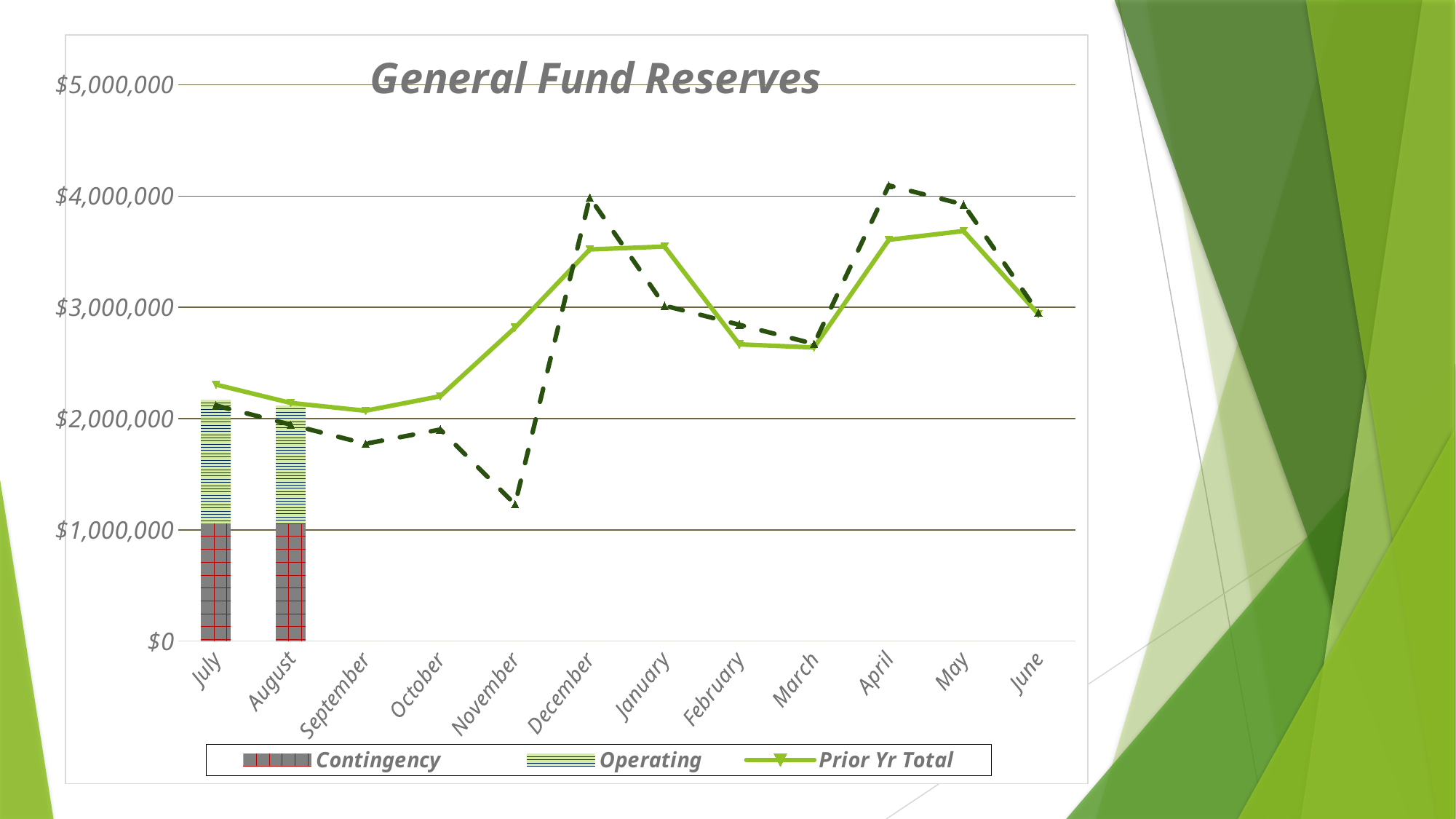
In which month does the dashed line reach its lowest value? November How many series does the legend list? 3 Does the Prior Yr Total line rise or fall from September to December? rise What is the title of the chart? General Fund Reserves Is the total height of the stacked bar for July greater or less than $2,000,000? greater How many months are shown on the x axis? 12 For how many months are stacked bars plotted? 2 Is the Prior Yr Total value for July greater or less than $3,000,000? less What kind of chart is this? A combination bar and line chart In which month does the Prior Yr Total line reach its highest value? May Is the value of the dashed line for November greater or less than $2,000,000? less